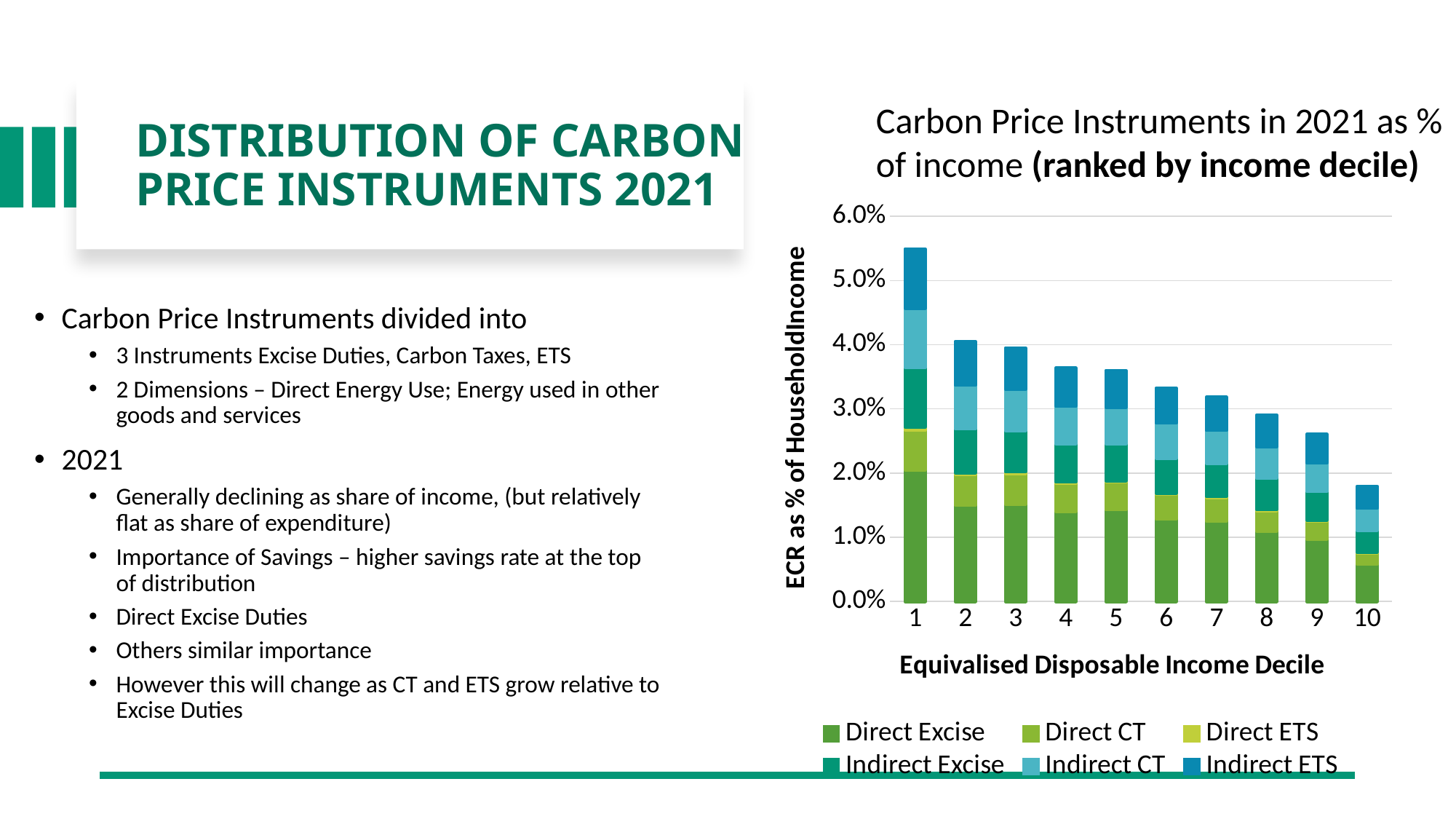
What kind of chart is shown on the slide? Stacked bar chart Which has a larger total value, decile 2 or decile 9? Decile 2 Is the total value for decile 9 greater or less than 3.0%? less How many income deciles are shown on the x axis of the chart? 10 Is the total value for decile 1 greater or less than 5.0%? greater How many series does the chart's legend list? 6 Which income decile has the lowest total ECR as % of household income? 10 Is the total value for decile 10 greater or less than 2.0%? less Which income decile has the highest total ECR as % of household income? 1 Do the total bar values generally rise or fall as the income decile increases from 1 to 10? Fall What is the title of the chart's x axis? Equivalised Disposable Income Decile